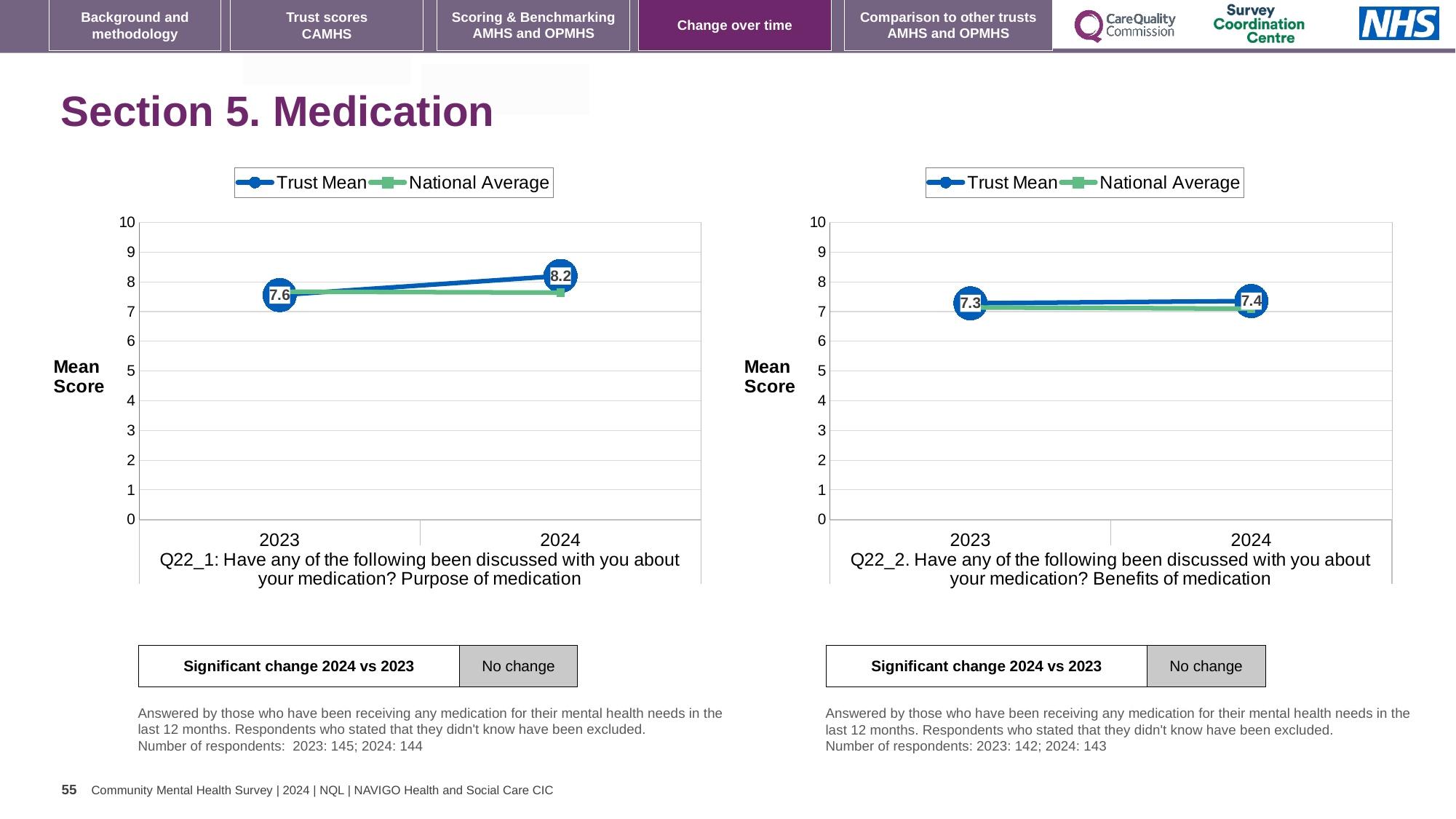
In the Q22_1 chart (left), what is the Trust Mean for 2024? 8.2 In the Q22_2 chart (right), what is the difference between the Trust Mean in 2024 and in 2023? 0.1 In the Q22_1 chart (left), is the National Average for 2024 greater or less than 8? less In the Q22_2 chart (right), what is the Trust Mean for 2024? 7.4 How many series does the legend of the Q22_2 chart (right) list? 2 How many years are plotted on the x axis of the Q22_1 chart (left)? 2 What kind of chart is used on this slide? line chart In the Q22_1 chart (left), what is the Trust Mean for 2023? 7.6 In the Q22_1 chart (left), which is larger in 2024, the Trust Mean or the National Average? Trust Mean In the Q22_1 chart (left), does the Trust Mean rise or fall from 2023 to 2024? rise In the Q22_2 chart (right), what is the Trust Mean for 2023? 7.3 In the Q22_1 chart (left), by how much did the Trust Mean change from 2023 to 2024? 0.6